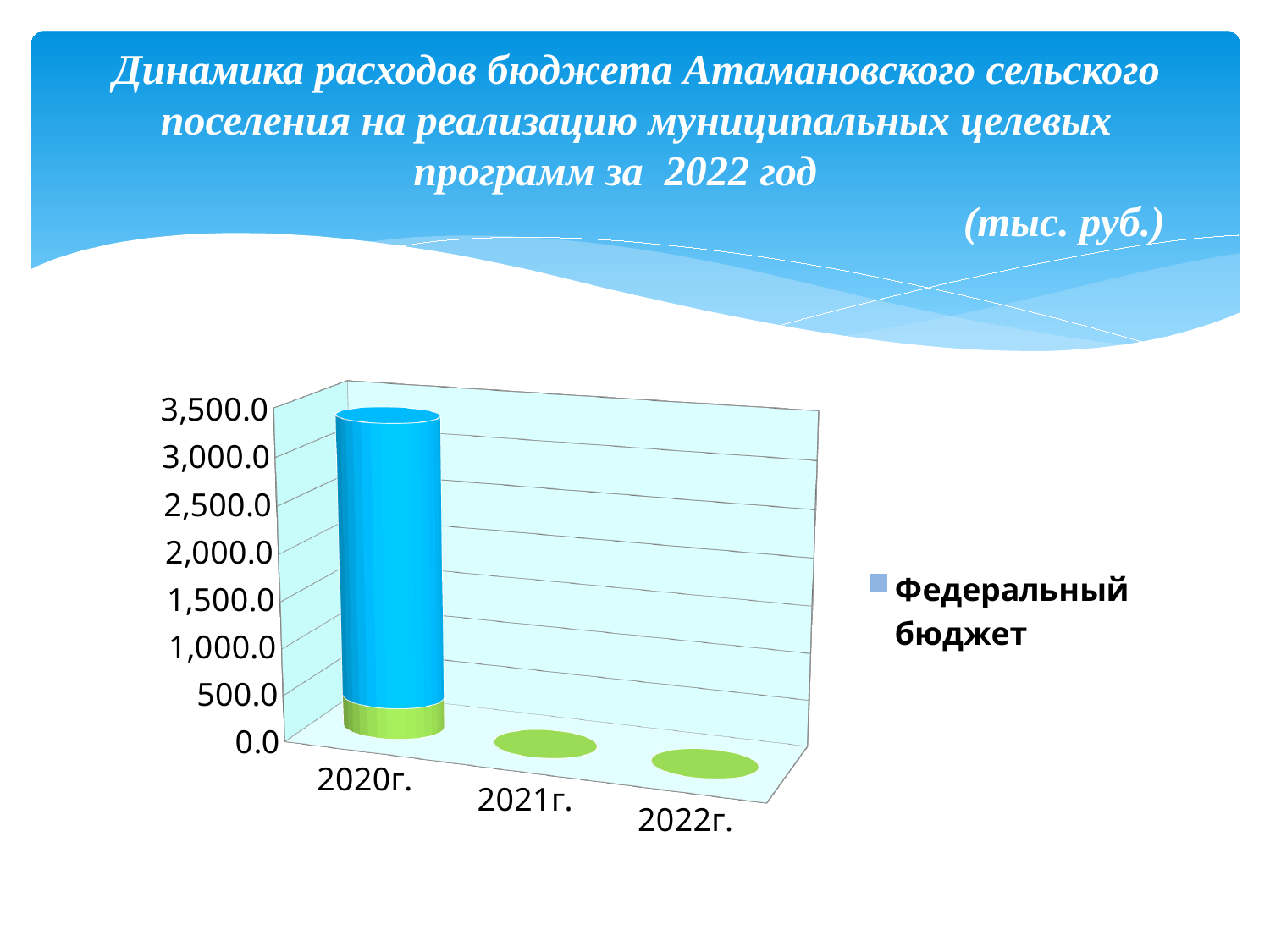
What kind of chart is shown on the slide? bar chart Is the value for 2020г. greater or less than 3,500.0? less Is the value for 2021г. greater or less than 500.0? less What is the highest tick value shown on the vertical axis of the chart? 3,500.0 Which year has the highest value in the chart? 2020г. Which is larger, the value for 2020г. or the value for 2022г.? 2020г. Do the values rise or fall from 2020г. to 2022г.? fall How many categories (years) are shown on the x axis of the chart? 3 What is the name of the series listed in the chart legend? Федеральный бюджет How many series does the chart legend list? 1 Is the value for 2020г. greater or less than 3,000.0? greater